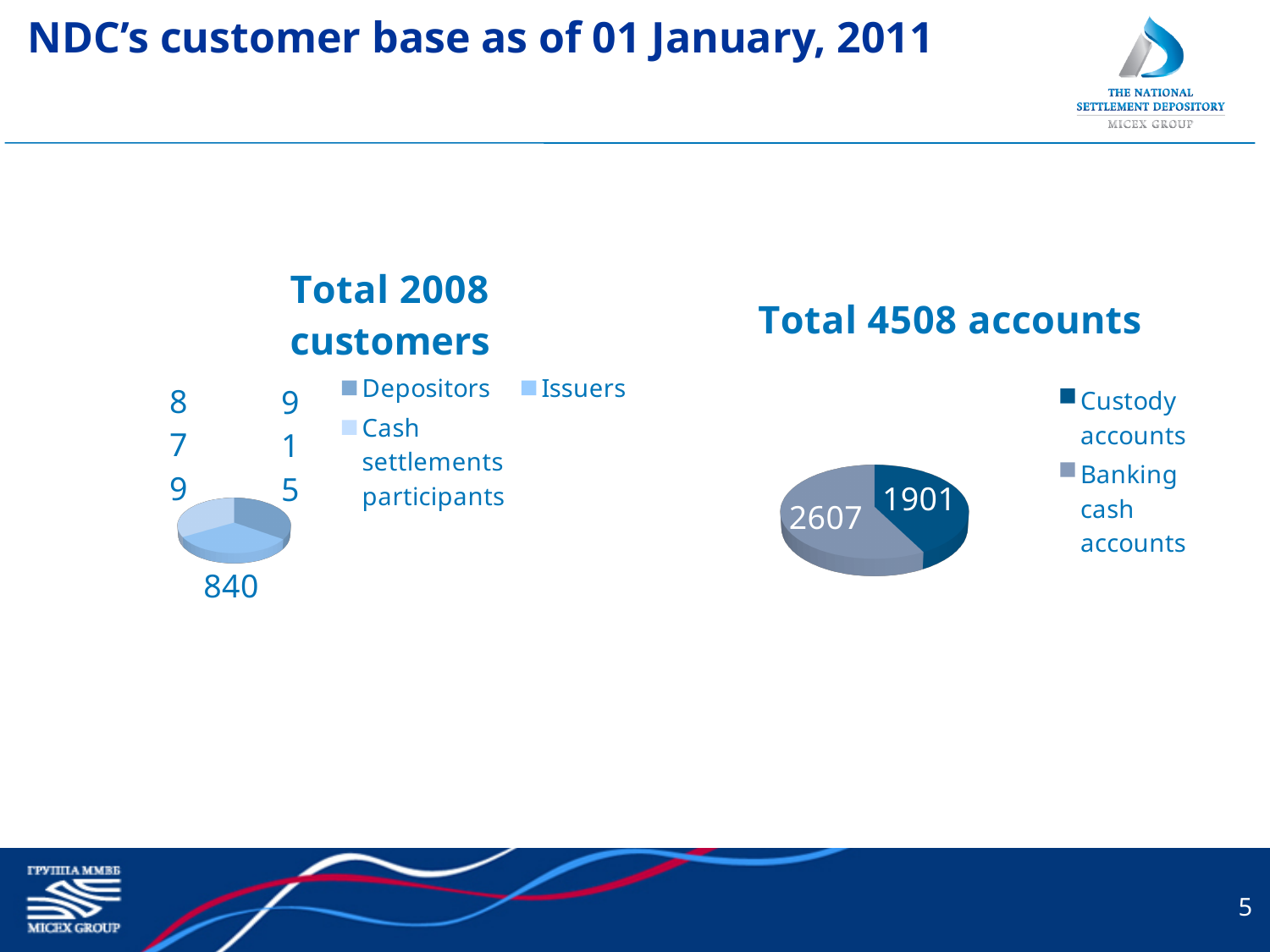
What kind of chart is the 'Total 2008 customers' chart? Pie chart On the 'Total 2008 customers' chart, what are the three legend entries? Depositors, Issuers, Cash settlements participants On the 'Total 4508 accounts' chart, which category has the smaller slice? Custody accounts On the 'Total 4508 accounts' chart, what is the total of the two slices? 4508 On the 'Total 4508 accounts' chart, are there more Custody accounts or Banking cash accounts? Banking cash accounts On the 'Total 4508 accounts' chart, how many Custody accounts are shown? 1901 On the 'Total 4508 accounts' chart, which category has the larger slice? Banking cash accounts On the 'Total 2008 customers' chart, how many categories does the legend list? 3 On the 'Total 4508 accounts' chart, how many categories does the legend list? 2 On the 'Total 4508 accounts' chart, what is the difference between Banking cash accounts and Custody accounts? 706 What kind of chart is the 'Total 4508 accounts' chart? Pie chart On the 'Total 4508 accounts' chart, how many Banking cash accounts are shown? 2607